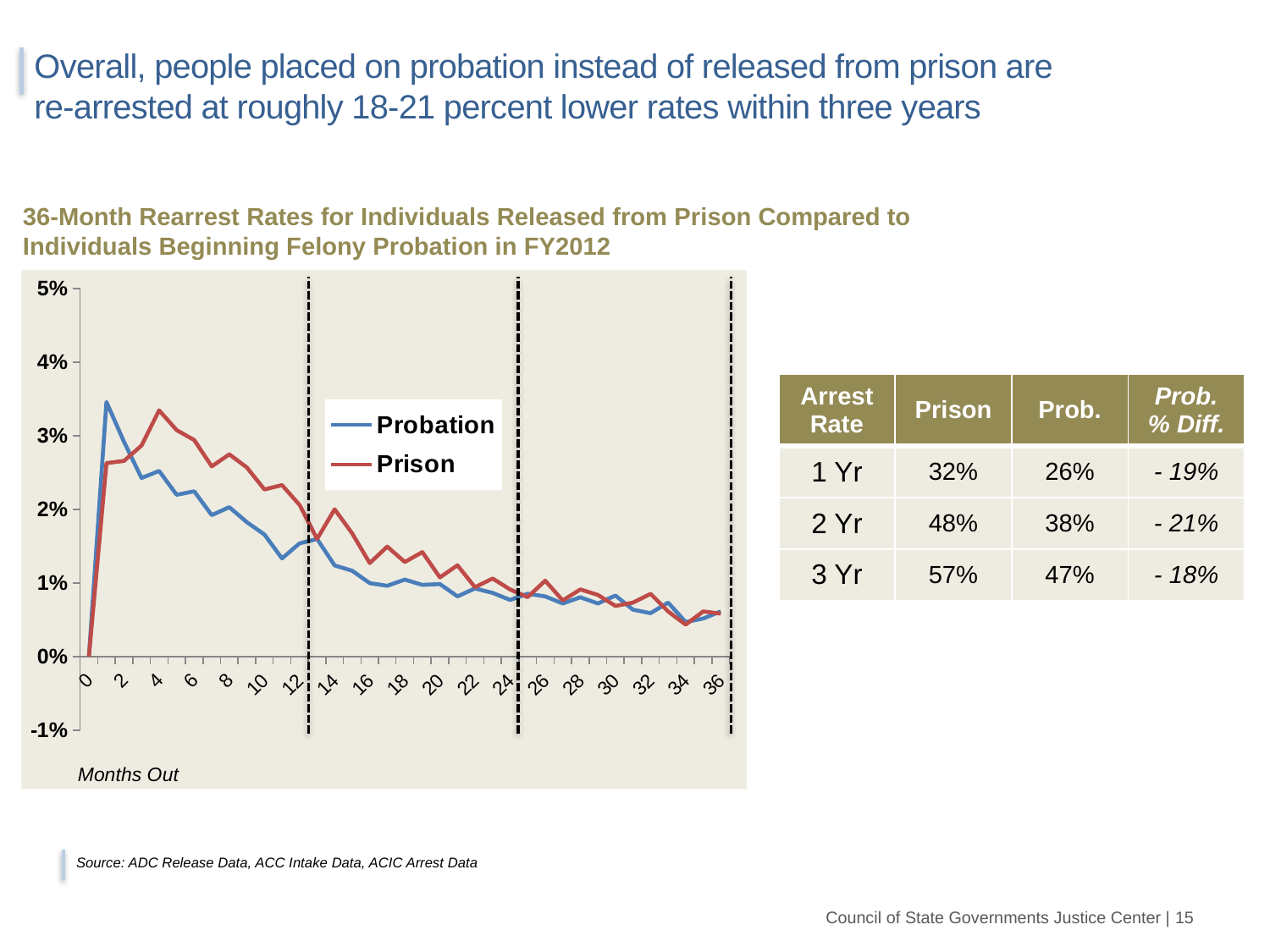
Is the Prison value at month 4 greater or less than 3%? greater Is the Probation value at month 1 greater or less than 3%? greater Is the Probation value at month 24 greater or less than 1%? less What is the label on the x axis of the chart? Months Out What are the two series named in the chart legend? Probation and Prison At month 1, which series has the higher value, Probation or Prison? Probation After their early peaks, do the Probation and Prison lines generally rise or fall as months out increase? fall What kind of chart is shown on the slide? line chart How many series does the chart legend list? 2 At month 4, which series has the higher value, Probation or Prison? Prison